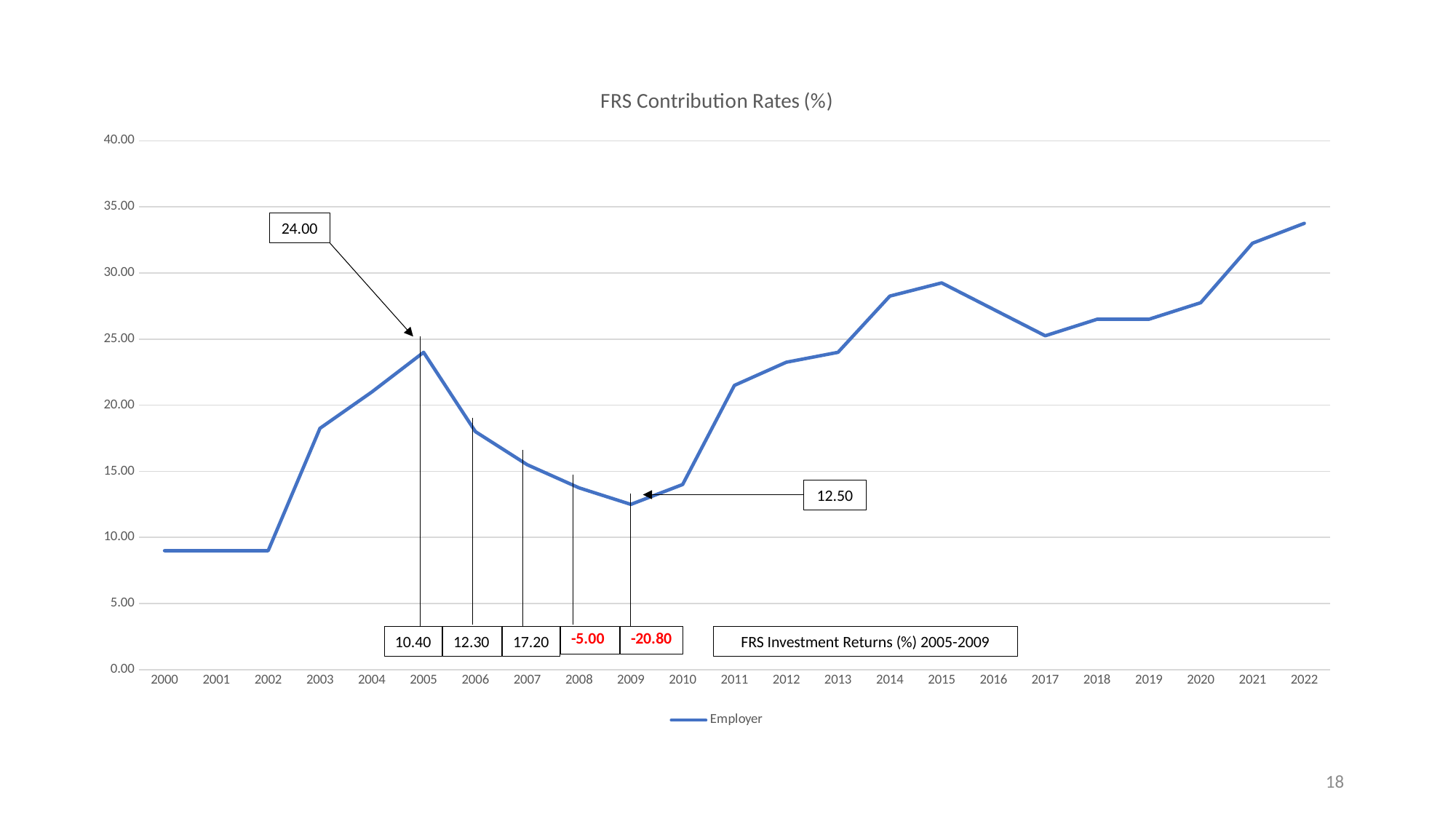
How many series does the legend list? 1 What is the Employer contribution rate for 2005? 24.00 Is the Employer contribution rate for 2000 greater or less than 10.00? less What is the Employer contribution rate for 2009? 12.50 What kind of chart is shown on the slide? line chart What is the difference between the Employer contribution rate in 2005 and in 2009? 11.50 Does the Employer contribution rate rise or fall from 2005 to 2009? fall How many years are plotted along the x axis? 23 What is the title of the chart? FRS Contribution Rates (%) Is the Employer contribution rate for 2022 greater or less than 30.00? greater Which year has the highest Employer contribution rate? 2022 What FRS investment return (%) is shown for 2009? -20.80